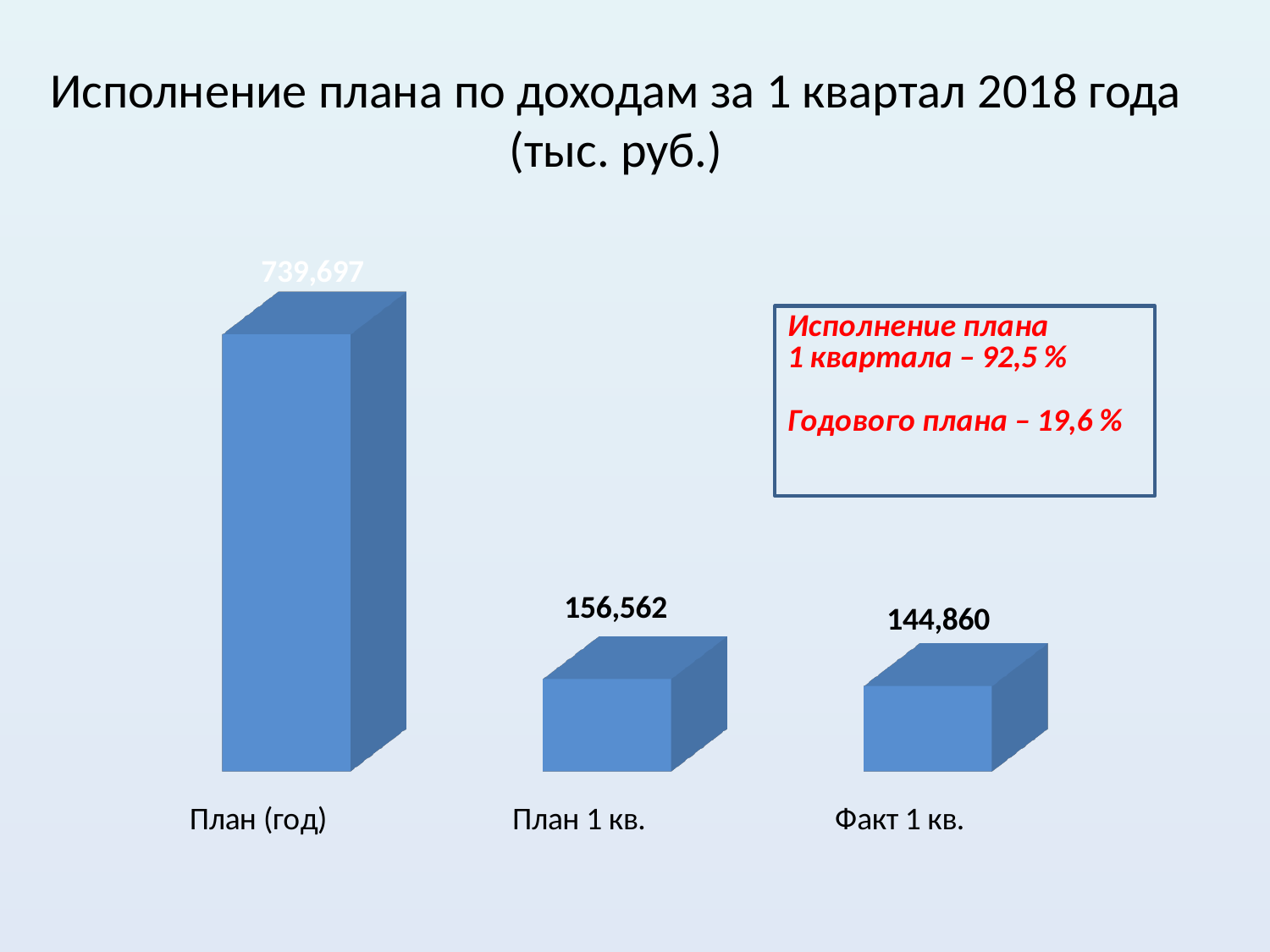
What kind of chart is shown on the slide? Bar chart What is the difference between План 1 кв. and Факт 1 кв.? 11,702 What is the value for План 1 кв.? 156,562 How many categories are shown in the chart? 3 What is the value for Факт 1 кв.? 144,860 What is the title of the slide? Исполнение плана по доходам за 1 квартал 2018 года (тыс. руб.) Which category has the highest value? План (год) Do the values rise or fall from left to right across the categories? Fall Which category has the lowest value? Факт 1 кв. Which is larger, План 1 кв. or Факт 1 кв.? План 1 кв. What is the value for План (год)? 739,697 What is the difference between План (год) and План 1 кв.? 583,135